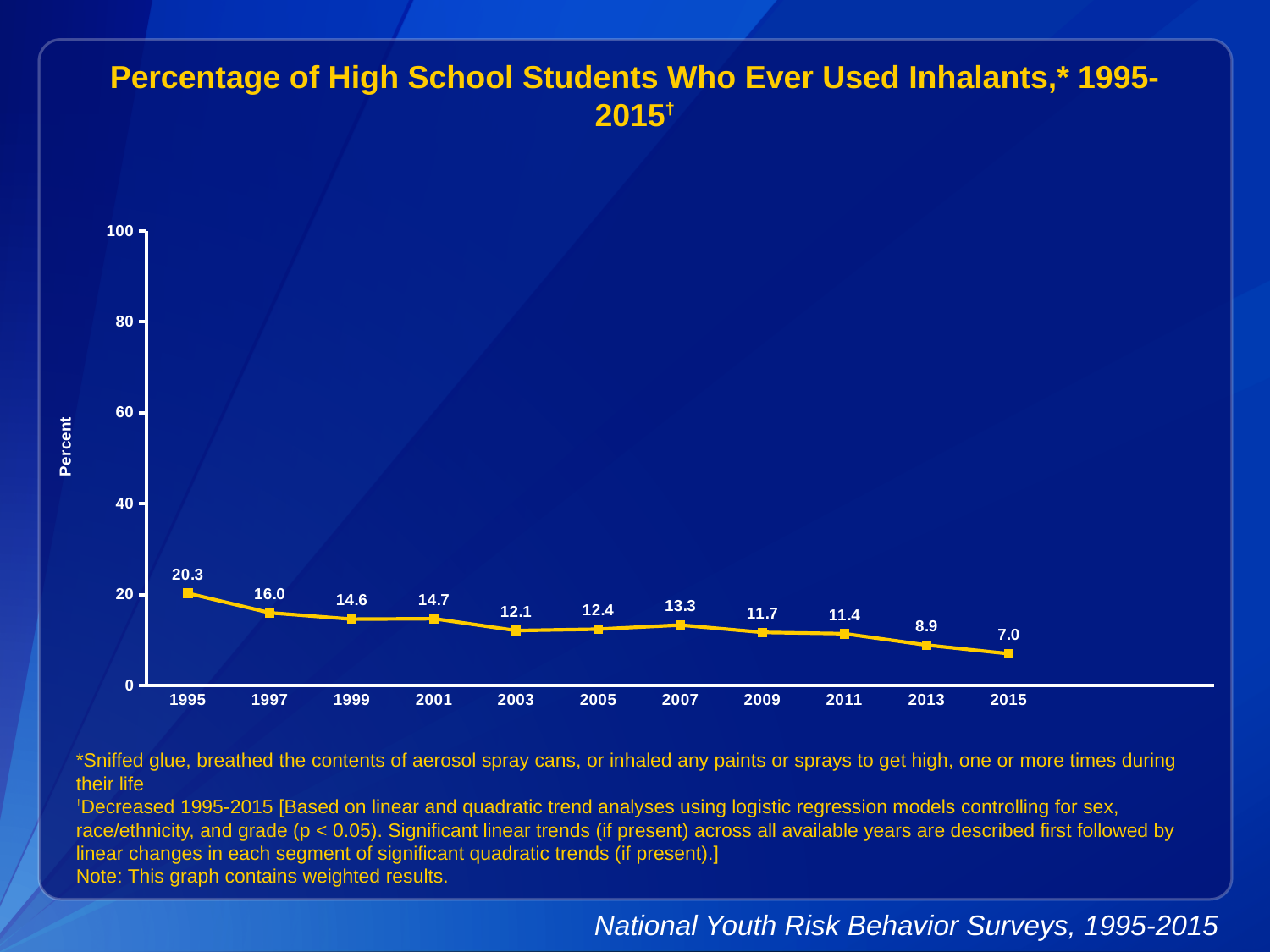
Which year has the lowest percentage of students who ever used inhalants? 2015 Which year has the highest percentage of students who ever used inhalants? 1995 What kind of chart is shown on the slide? line chart How many years are plotted on the x axis? 11 What is the value plotted for 2007? 13.3 What is the value plotted for 2015? 7.0 Do the values generally rise or fall from 1995 to 2015? fall What percentage of high school students had ever used inhalants in 1995? 20.3 What is the label on the y axis? Percent Which year has a higher value, 2003 or 2005? 2005 Is the value for 2013 greater or less than 20? less What is the difference between the 1995 value and the 2015 value? 13.3